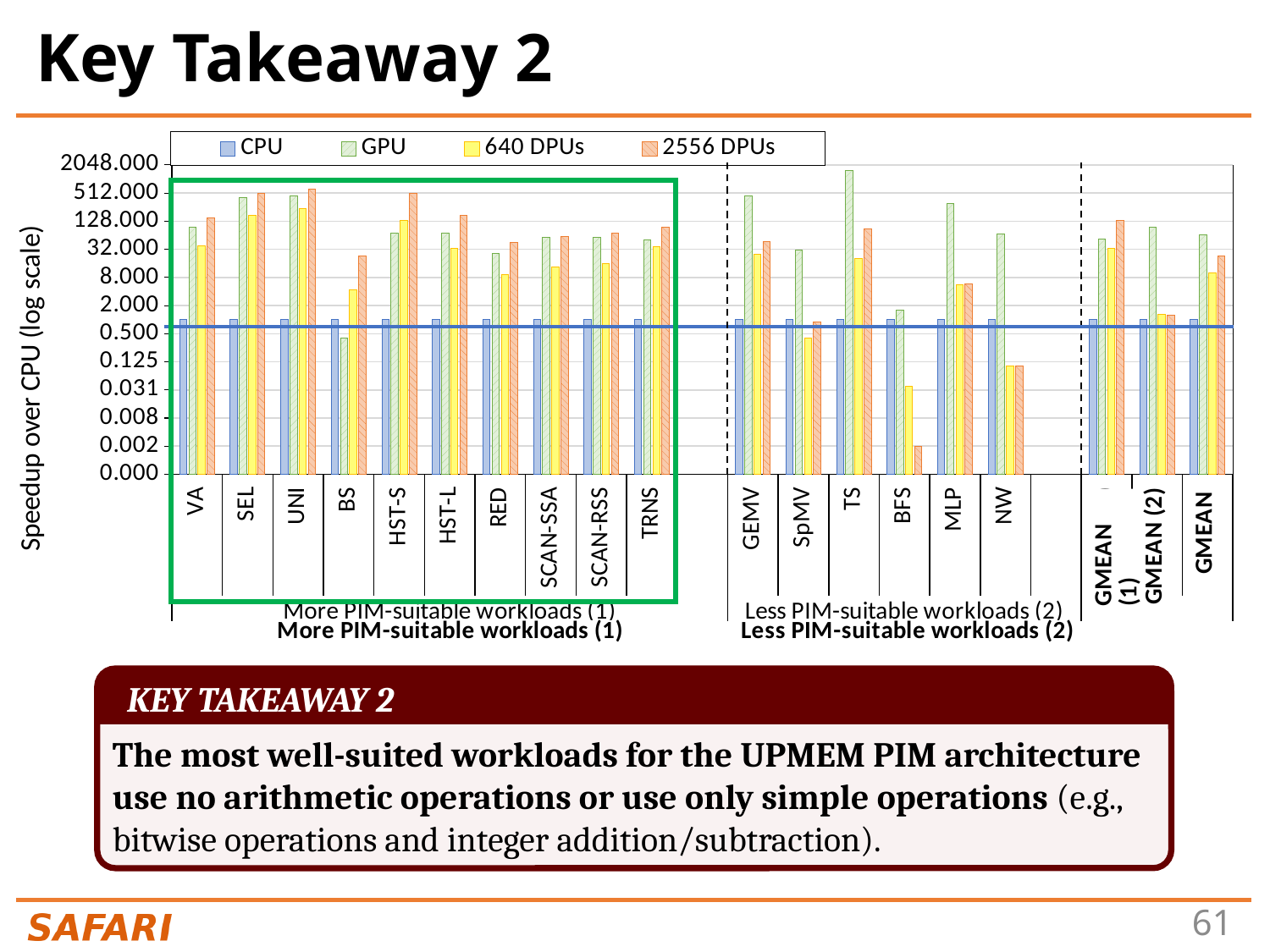
What is the title of the vertical axis of the chart? Speedup over CPU (log scale) Is the 640 DPUs value for NW greater or less than 0.500? less Which category has the highest GPU bar in the chart? TS What kind of chart is shown on the slide? bar chart Is the GPU value for TS greater or less than 512.000? greater How many workload categories are plotted on the x axis of the chart, including the GMEAN categories? 19 Which category has the lowest 2556 DPUs bar in the chart? BFS Which series are listed in the chart legend? CPU, GPU, 640 DPUs, 2556 DPUs For GEMV, which is larger: the GPU value or the 640 DPUs value? GPU How many series does the chart legend list? 4 Is the 2556 DPUs value for BFS greater or less than 0.125? less For BFS, which is larger: the 640 DPUs value or the 2556 DPUs value? 640 DPUs